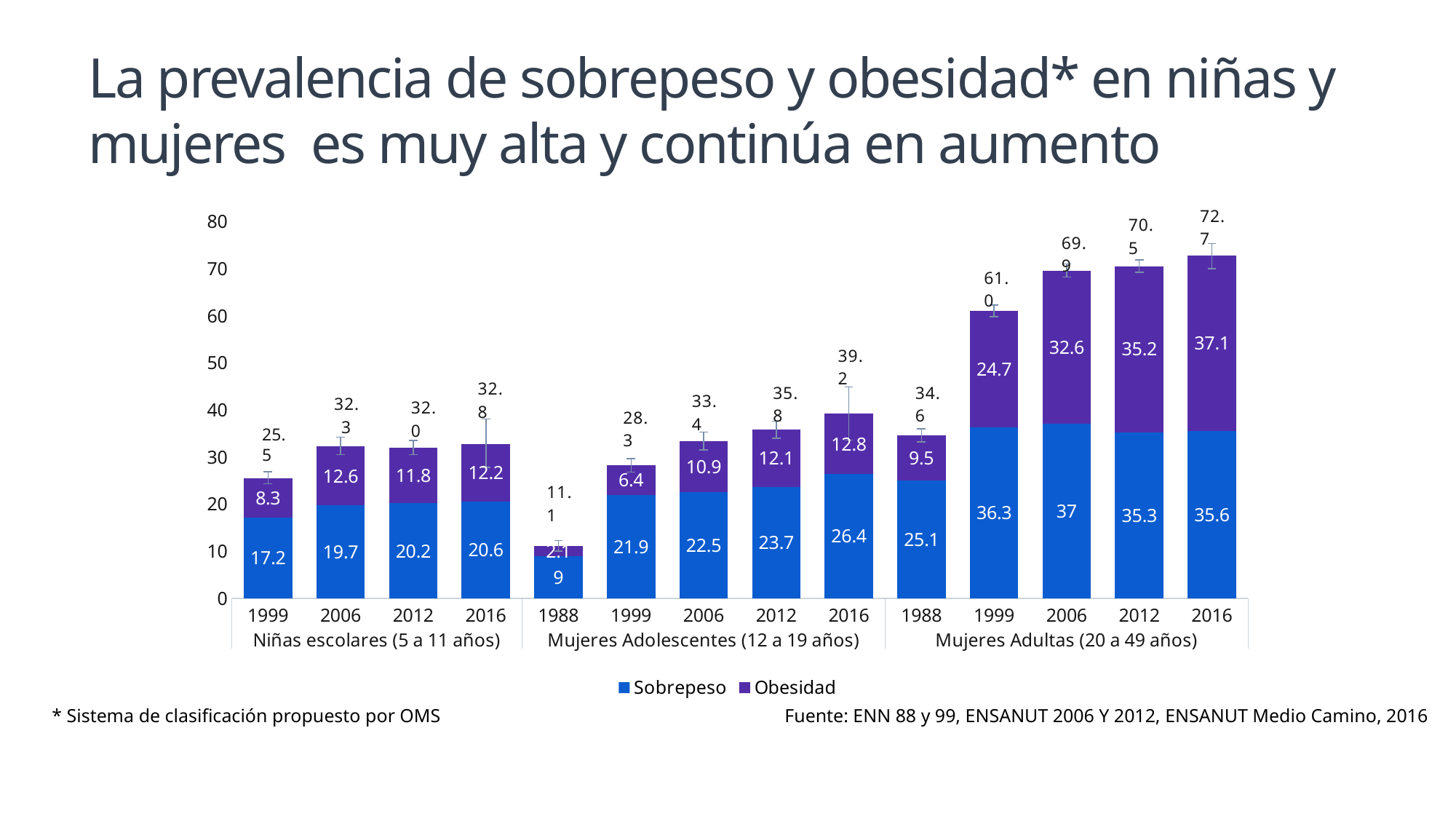
What is the total of the stacked bar for 1988 in the Mujeres Adolescentes (12 a 19 años) group? 11.1 Which year has the highest Obesidad value in the Mujeres Adultas (20 a 49 años) group? 2016 What is the Sobrepeso value for 2016 in the Mujeres Adultas (20 a 49 años) group? 35.6 What is the difference between the Sobrepeso values for 2016 and 1988 in the Mujeres Adolescentes (12 a 19 años) group? 17.4 What is the total of the stacked bar for 2016 in the Mujeres Adultas (20 a 49 años) group? 72.7 What is the Obesidad value for 1999 in the Mujeres Adolescentes (12 a 19 años) group? 6.4 What kind of chart is shown on the slide? Stacked bar chart How many series does the legend list? 2 What is the Obesidad value for 2006 in the Niñas escolares (5 a 11 años) group? 12.6 How many stacked bars are plotted in the chart? 14 Which is larger: the Obesidad value for 2012 in the Mujeres Adultas group or the Obesidad value for 2012 in the Niñas escolares group? Mujeres Adultas (35.2) Which bar has the lowest total across the whole chart? 1988, Mujeres Adolescentes (12 a 19 años)